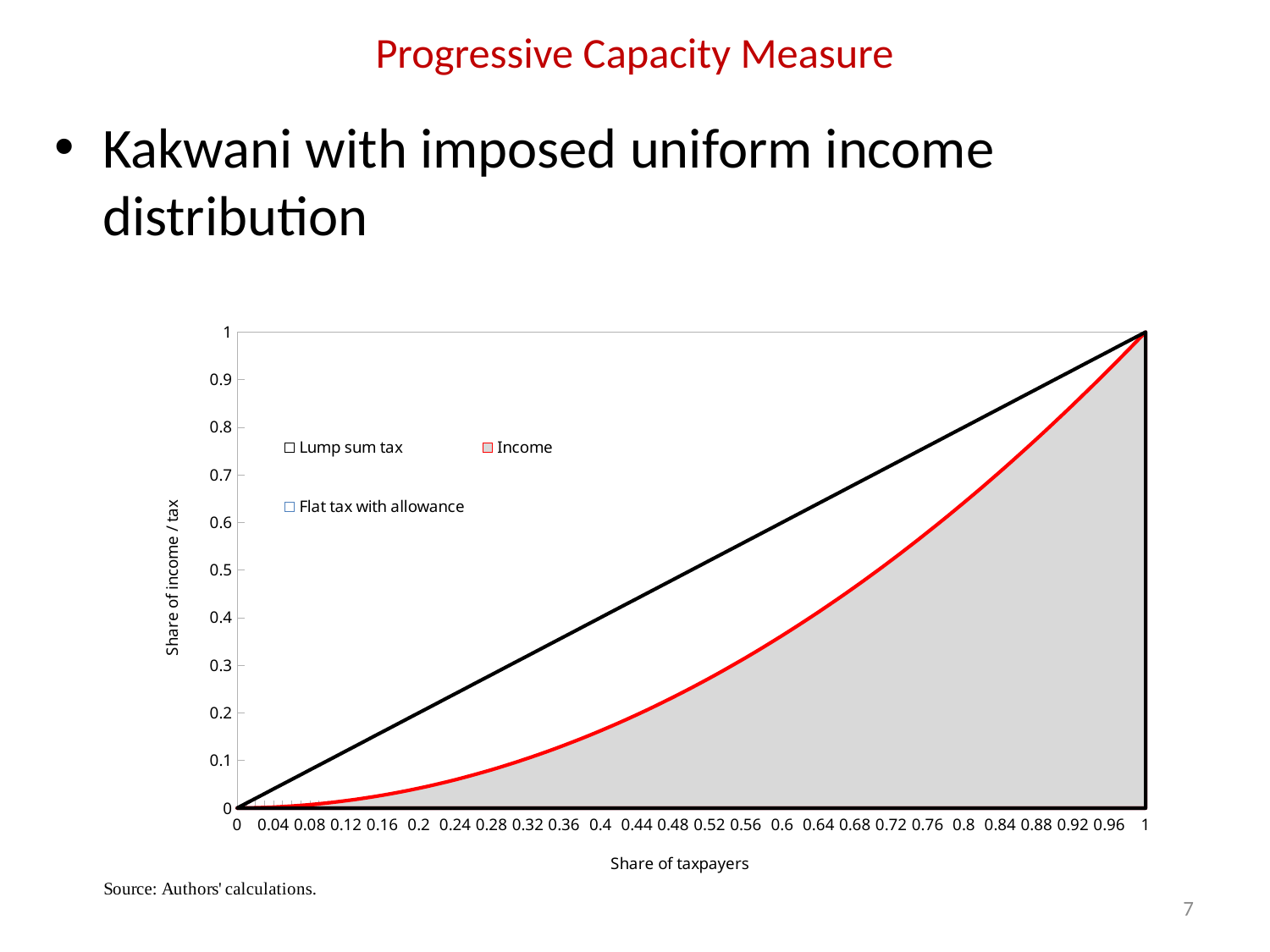
Is the value of the Income series at a share of taxpayers of 0.8 greater or less than 0.7? less How many series does the chart legend list? 3 Is the value of the Income series at a share of taxpayers of 0.6 greater or less than 0.5? less What is the value of the Lump sum tax series at a share of taxpayers of 0? 0 Which series is drawn as a straight diagonal line from the origin to the top right corner? Lump sum tax Does the Income series rise or fall as the share of taxpayers increases along the x axis? rise What value does the Income series reach at a share of taxpayers of 1? 1 At a share of taxpayers of 0.4, which series has the larger value, Lump sum tax or Income? Lump sum tax What is the title of the y axis of the chart? Share of income / tax What is the title of the x axis of the chart? Share of taxpayers Is the value of the Lump sum tax series at a share of taxpayers of 0.6 greater or less than 0.5? greater